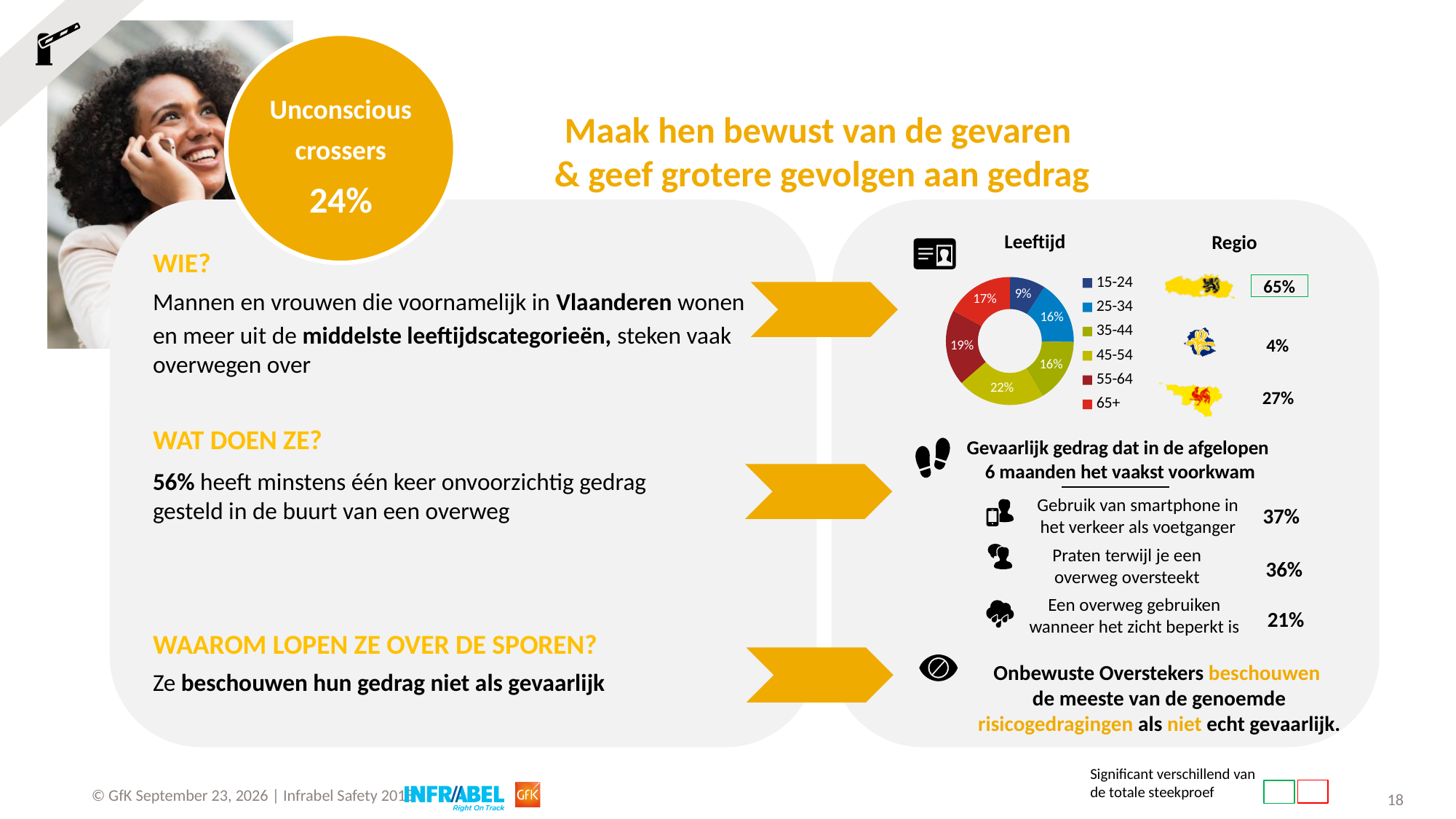
In the 'Leeftijd' chart, what share is shown for the 55-64 age group? 19% In the 'Leeftijd' chart, what share is shown for the 45-54 age group? 22% Which age group has the largest share in the 'Leeftijd' chart? 45-54 In the 'Leeftijd' chart, what share is shown for the 15-24 age group? 9% How many entries does the legend of the 'Leeftijd' chart list? 6 Which age group has the smallest share in the 'Leeftijd' chart? 15-24 In the 'Leeftijd' chart, what share is shown for the 25-34 age group? 16% What type of chart is the 'Leeftijd' chart? Donut (pie) chart In the 'Leeftijd' chart, which has the larger share: 55-64 or 65+? 55-64 In the 'Leeftijd' chart, what share is shown for the 65+ age group? 17% In the 'Leeftijd' chart, what is the difference in percentage points between the 45-54 and 15-24 age groups? 13 How many age groups are shown in the 'Leeftijd' chart? 6